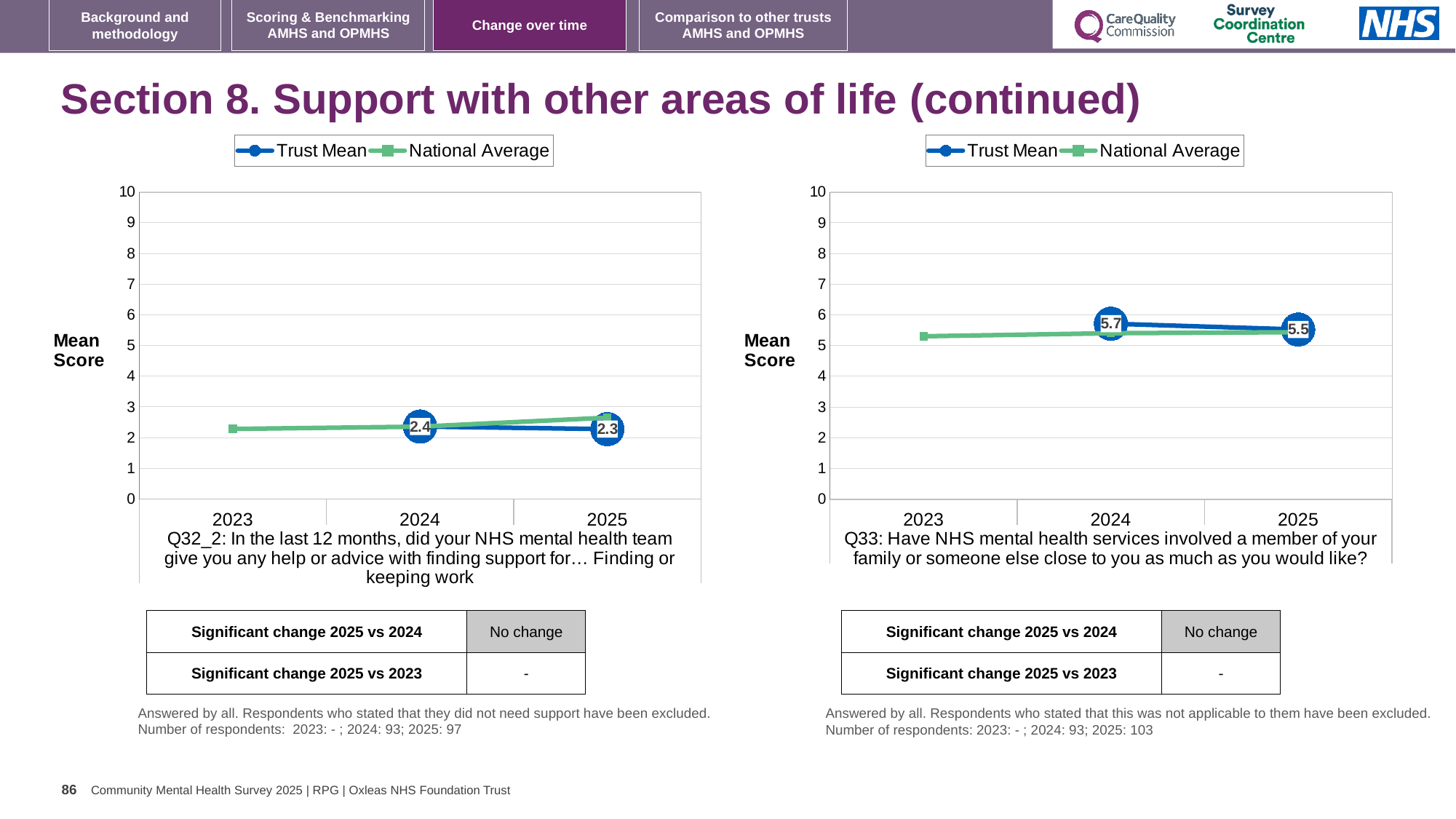
On the left chart (Q32_2), what is the Trust Mean value for 2024? 2.4 On the right chart (Q33), what is the Trust Mean value for 2025? 5.5 On the left chart (Q32_2), is the National Average value for 2025 greater or less than 3? less How many years are shown on the x axis of the left chart (Q32_2)? 3 On the right chart (Q33), what is the Trust Mean value for 2024? 5.7 On the left chart (Q32_2), what is the difference between the Trust Mean for 2024 and 2025? 0.1 On the right chart (Q33), what is the difference between the Trust Mean for 2024 and 2025? 0.2 On the right chart (Q33), does the Trust Mean rise or fall from 2024 to 2025? fall On the left chart (Q32_2), what is the Trust Mean value for 2025? 2.3 What kind of chart is the left chart (Q32_2)? line chart On the right chart (Q33), is the National Average value for 2023 greater or less than 5? greater How many series does the legend of the right chart (Q33) list? 2